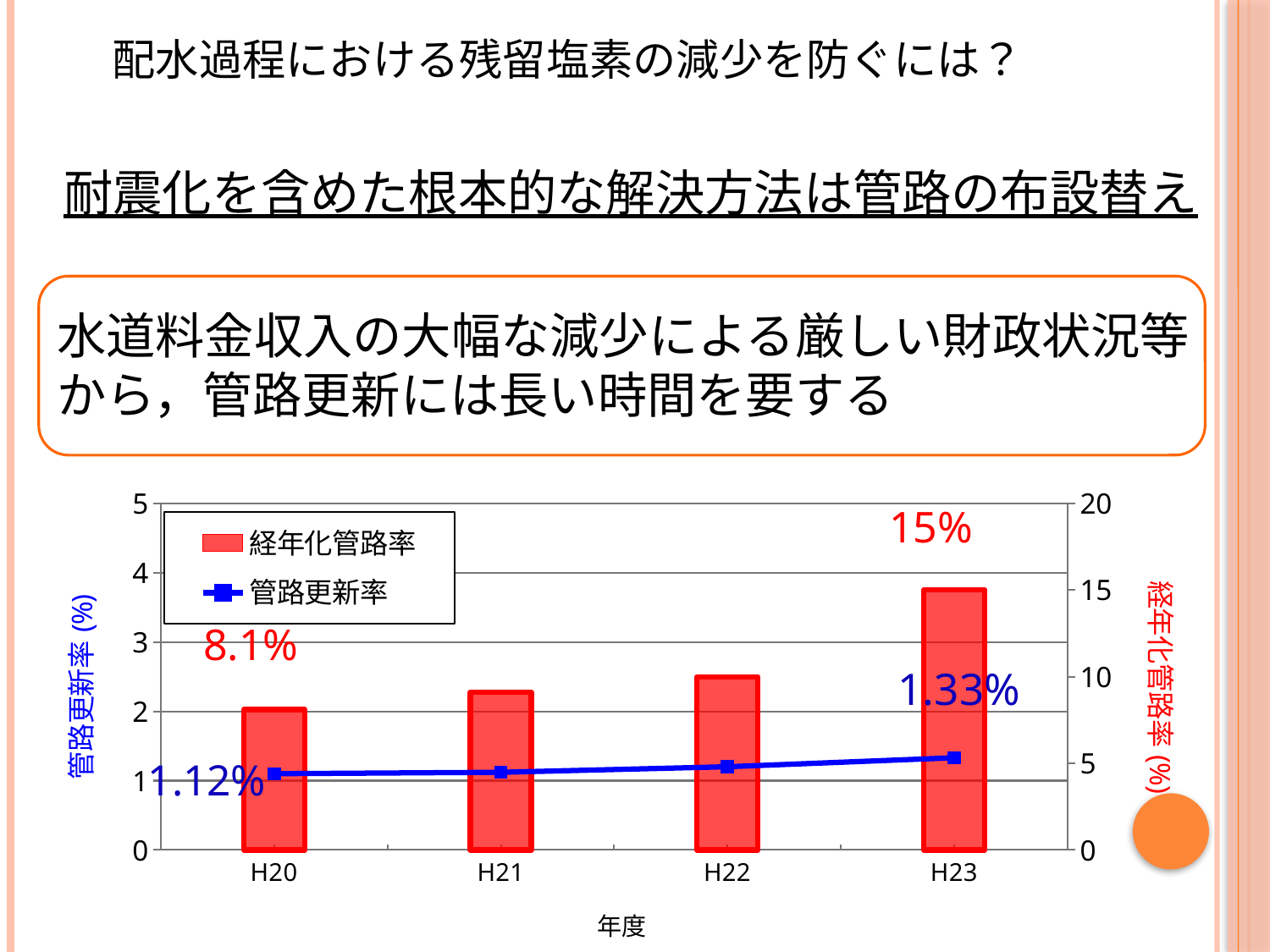
What is the 経年化管路率 value labelled for H23? 15% What is the 経年化管路率 value labelled for H20? 8.1% What is the 管路更新率 value labelled for H23? 1.33% What kind of chart is shown on the slide? Combined bar and line chart How many years are shown on the x axis? 4 Does the 管路更新率 line rise or fall from H20 to H23? Rise Is the 経年化管路率 bar for H21 greater or less than 10 on the right axis? less By how many percentage points did 経年化管路率 increase from H20 to H23? 6.9 Which year has the highest 経年化管路率 bar? H23 Which year has the lowest 経年化管路率 bar? H20 How many series does the legend list? 2 What is the 管路更新率 value labelled for H20? 1.12%